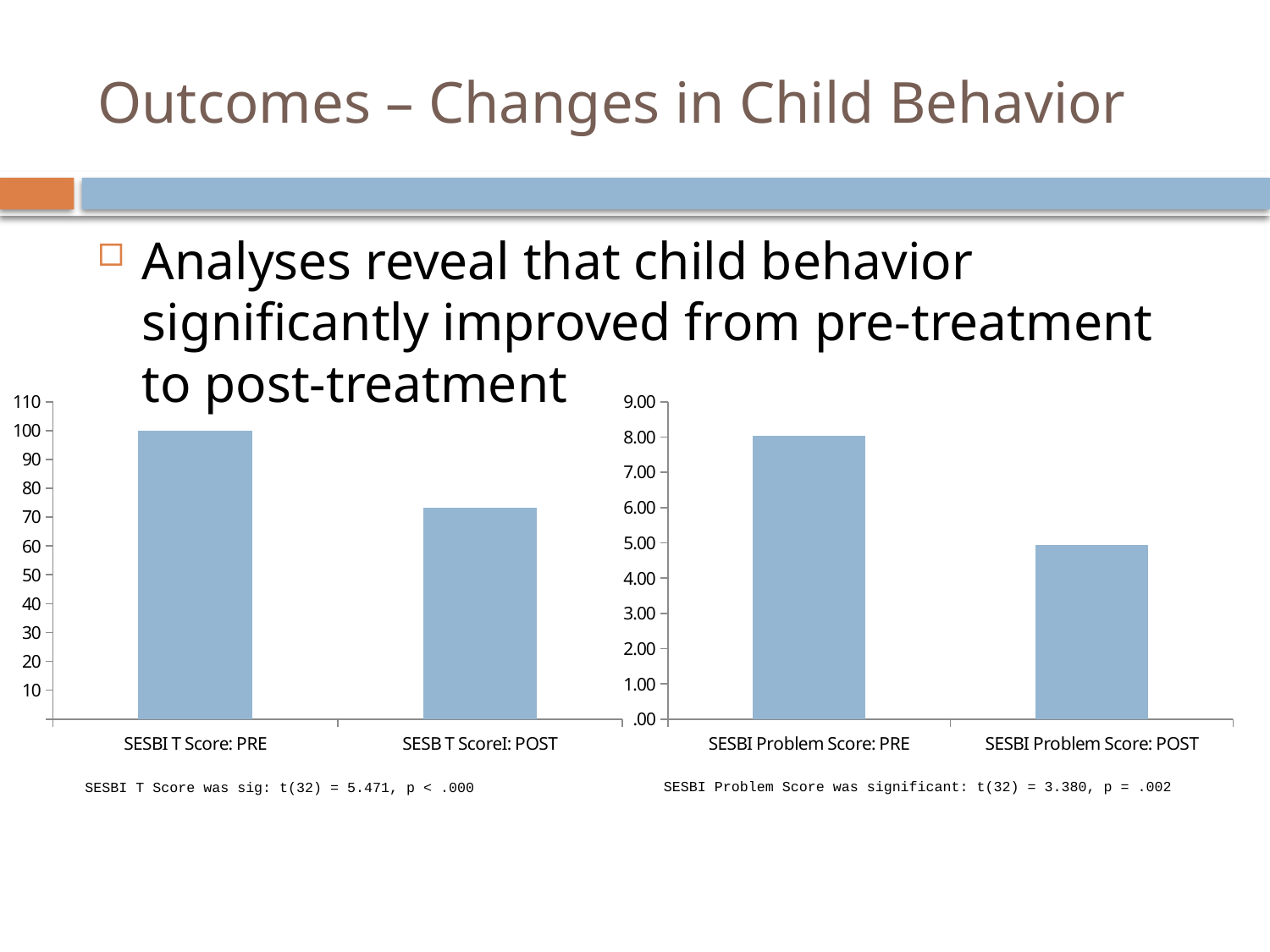
In the left chart (SESBI T Score), which is larger: the PRE value or the POST value? SESBI T Score: PRE In the left chart (SESBI T Score), is the value for SESBI T Score: PRE greater or less than 90? greater In the right chart (SESBI Problem Score), which category has the lowest value? SESBI Problem Score: POST In the left chart (SESBI T Score), which category has the highest value? SESBI T Score: PRE In the left chart (SESBI T Score), is the value for SESB T ScoreI: POST greater or less than 80? less What colour are the bars in the right chart (SESBI Problem Score)? blue In the right chart (SESBI Problem Score), is the value for SESBI Problem Score: PRE greater or less than 7.00? greater In the right chart (SESBI Problem Score), do the values rise or fall from PRE to POST? fall How many bars does the right chart (SESBI Problem Score) show? 2 How many bars does the left chart (SESBI T Score) show? 2 What kind of chart is the left chart (SESBI T Score)? bar chart